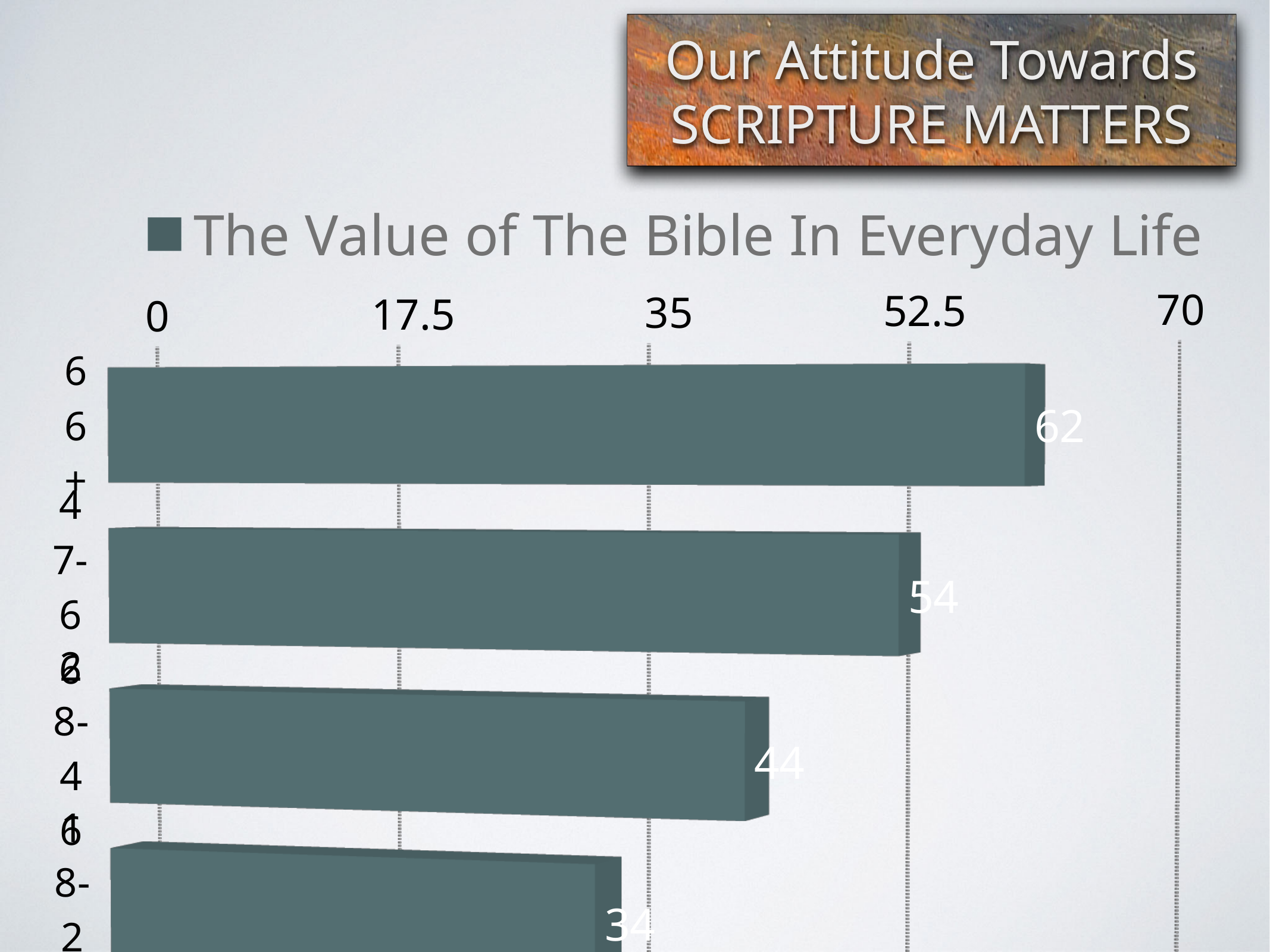
What is the difference between the top bar (62) and the second bar (54)? 8 What kind of chart is shown on the slide? bar chart What is the difference between the highest value and the lowest value in the chart? 28 What is the value of the third bar from the top? 44 What is the value of the top (longest) bar in the chart? 62 What series name does the legend show? The Value of The Bible In Everyday Life What is the value of the second bar from the top? 54 What is the highest value shown in the chart? 62 What is the value of the bottom bar in the chart? 34 How many bars are shown in the chart? 4 Which is larger, the second bar from the top or the third bar from the top? the second bar from the top What is the lowest value shown in the chart? 34